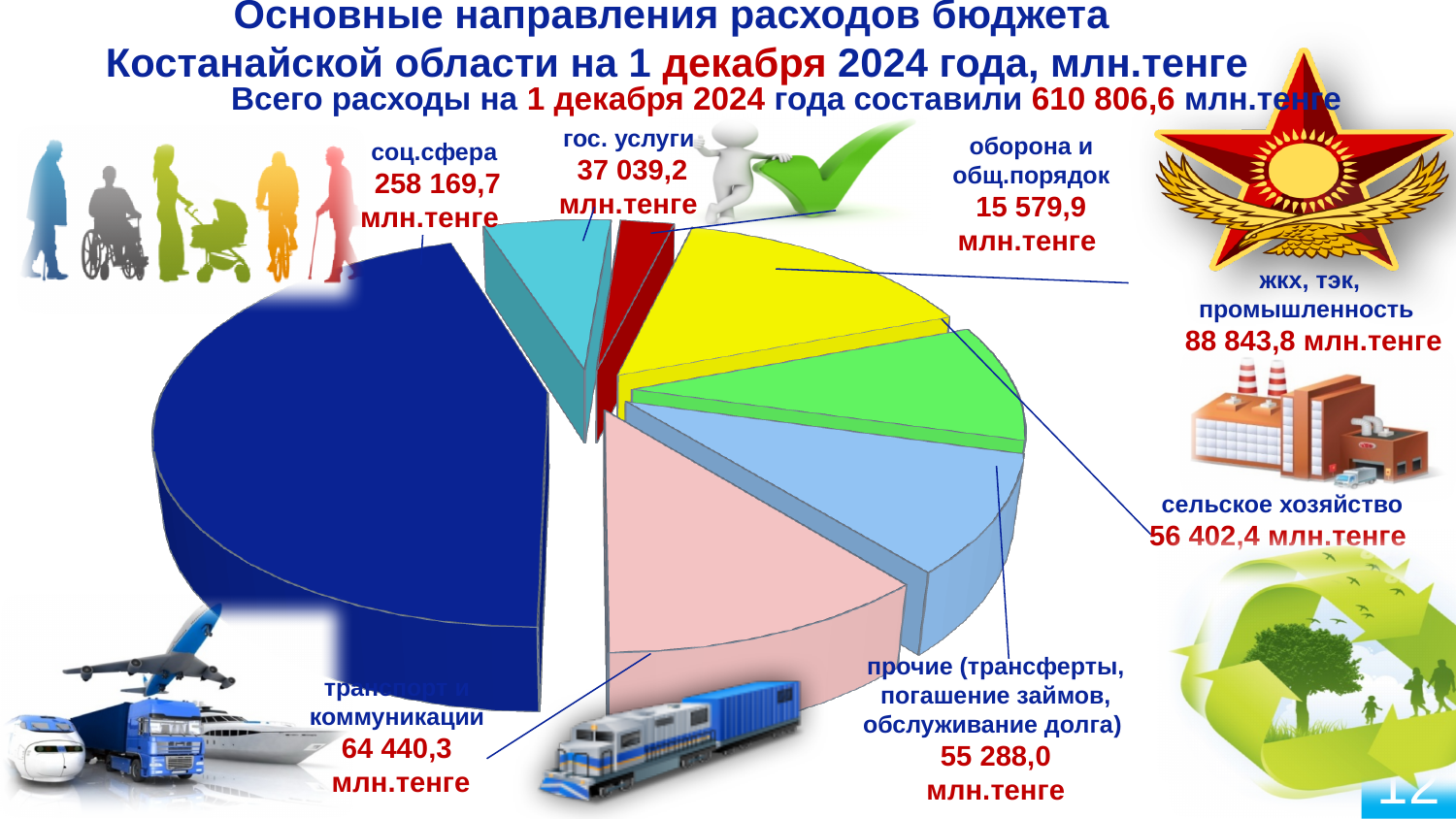
What kind of chart is shown on the slide? pie chart What is the value for гос. услуги? 37 039,2 млн.тенге Which is larger: транспорт и коммуникации or сельское хозяйство? транспорт и коммуникации What is the value for сельское хозяйство? 56 402,4 млн.тенге What is the value for оборона и общ.порядок? 15 579,9 млн.тенге What total expenditure as of 1 December 2024 is stated on the slide? 610 806,6 млн.тенге What is the difference between соц.сфера and жкх, тэк, промышленность? 169 325,9 млн.тенге What is the value for соц.сфера? 258 169,7 млн.тенге Which category has the largest expenditure? соц.сфера Which category has the smallest expenditure? оборона и общ.порядок How many categories (slices) does the pie chart have? 7 What is the difference between гос. услуги and оборона и общ.порядок? 21 459,3 млн.тенге